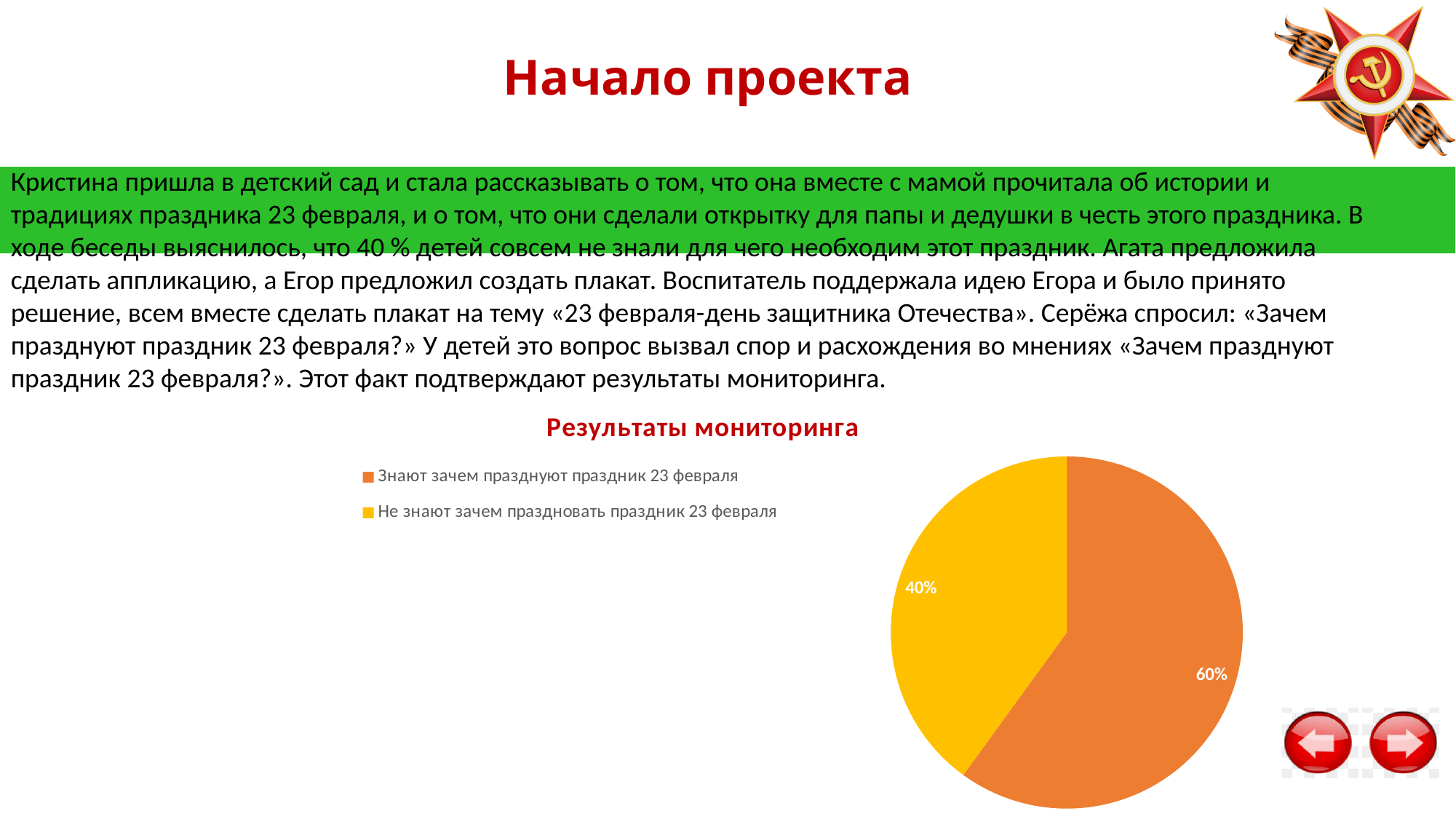
What colour is the slice for "Не знают зачем праздновать праздник 23 февраля"? yellow Which category has the smallest slice of the pie? Не знают зачем праздновать праздник 23 февраля What is the difference in percentage points between the "Знают" slice and the "Не знают" slice? 20% What share of the pie is labelled "Знают зачем празднуют праздник 23 февраля"? 60% How many slices does the pie chart have? 2 What share of the pie is labelled "Не знают зачем праздновать праздник 23 февраля"? 40% How many entries does the legend list? 2 What is the title of the chart? Результаты мониторинга Which is larger: the slice for "Знают зачем празднуют праздник 23 февраля" or the slice for "Не знают зачем праздновать праздник 23 февраля"? Знают зачем празднуют праздник 23 февраля Which category has the largest slice of the pie? Знают зачем празднуют праздник 23 февраля What kind of chart is shown on the slide? pie chart